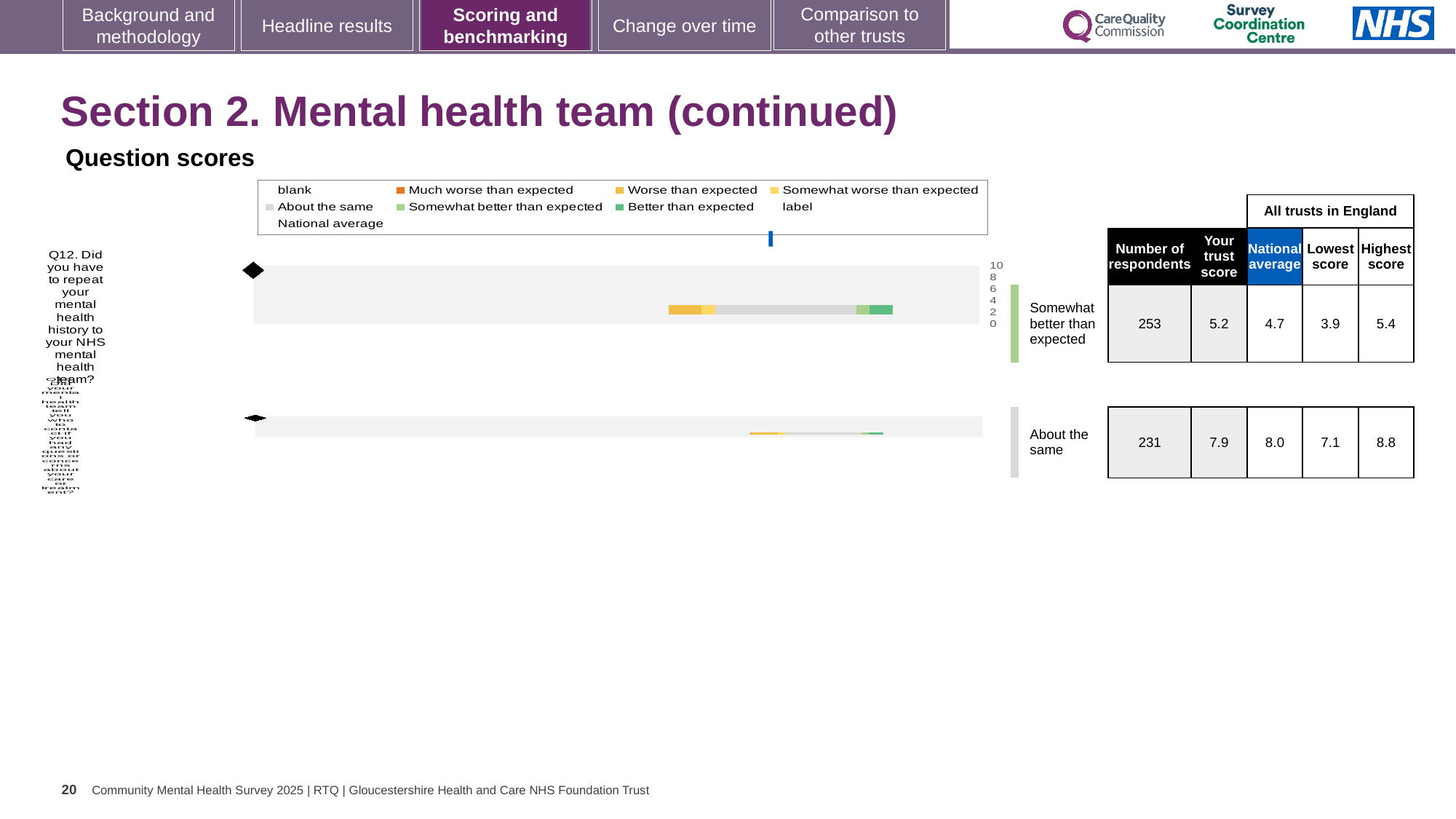
What is the highest score among all trusts in England for Q12? 5.4 What is the trust score for Q12 (Did you have to repeat your mental health history to your NHS mental health team?)? 5.2 What is the lowest score among all trusts in England for Q12? 3.9 For Q12, what is the difference between the highest and lowest scores among all trusts in England? 1.5 What is the national average score for Q12? 4.7 For Q12, what is the difference between the trust score and the national average? 0.5 How many question rows are plotted on the chart? 2 For Q12, which is larger: the trust score or the national average? the trust score Which benchmark category is Q12 placed in? Somewhat better than expected What kind of chart is used to show the question scores on this slide? bar chart What colour does the legend use for 'Better than expected'? green How many respondents answered Q12? 253